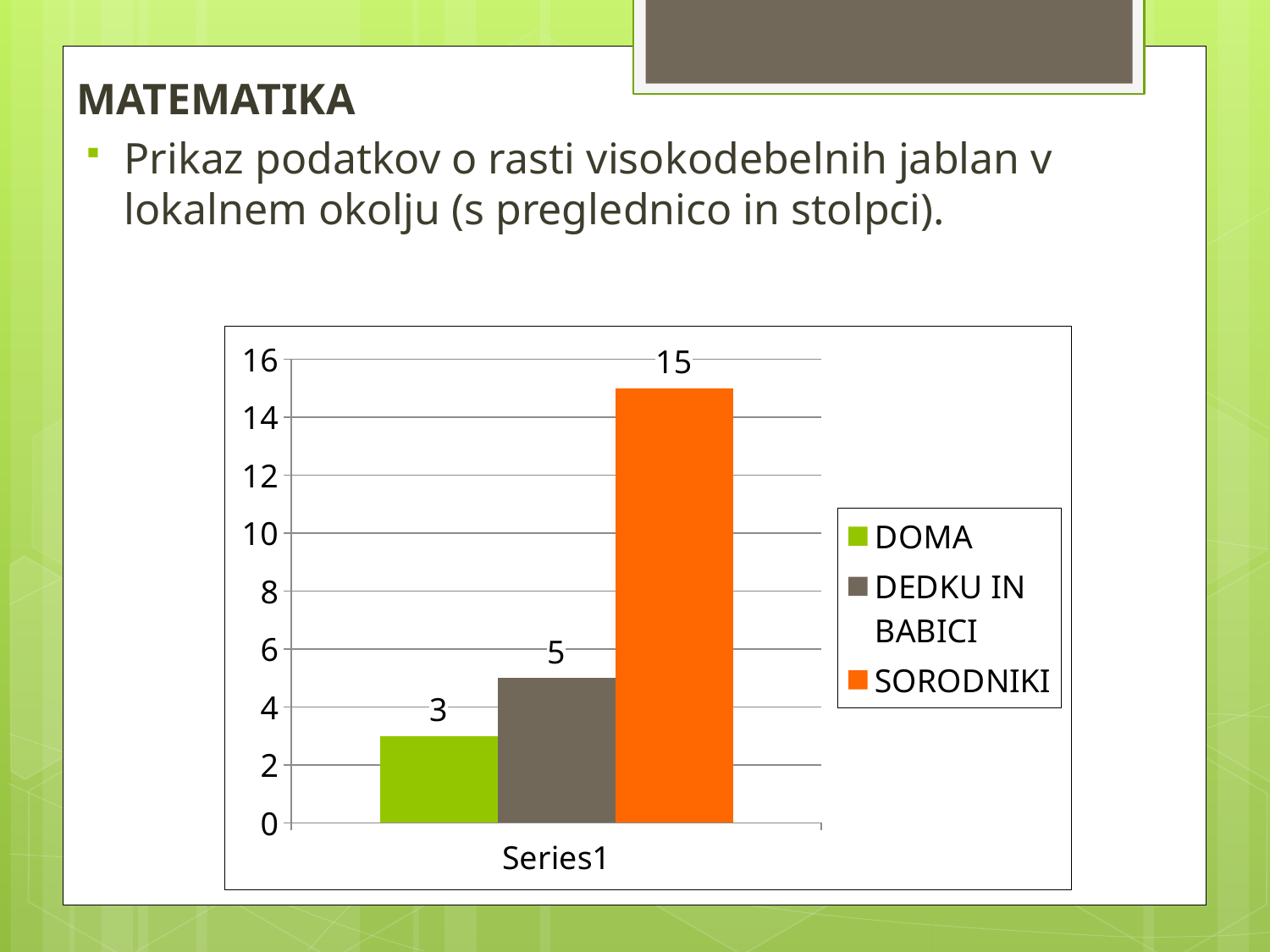
What is the value for SORODNIKI? 15 Which series has the lowest value? DOMA What is the value for DEDKU IN BABICI? 5 What is the difference between the values for DEDKU IN BABICI and DOMA? 2 What is the value for DOMA? 3 What colour is the bar for SORODNIKI? orange Which series has the highest value? SORODNIKI Which is larger, the value for DEDKU IN BABICI or the value for SORODNIKI? SORODNIKI What kind of chart is shown on the slide? bar chart Is the value for SORODNIKI greater or less than 10? greater How many series does the legend list? 3 What is the difference between the values for SORODNIKI and DOMA? 12